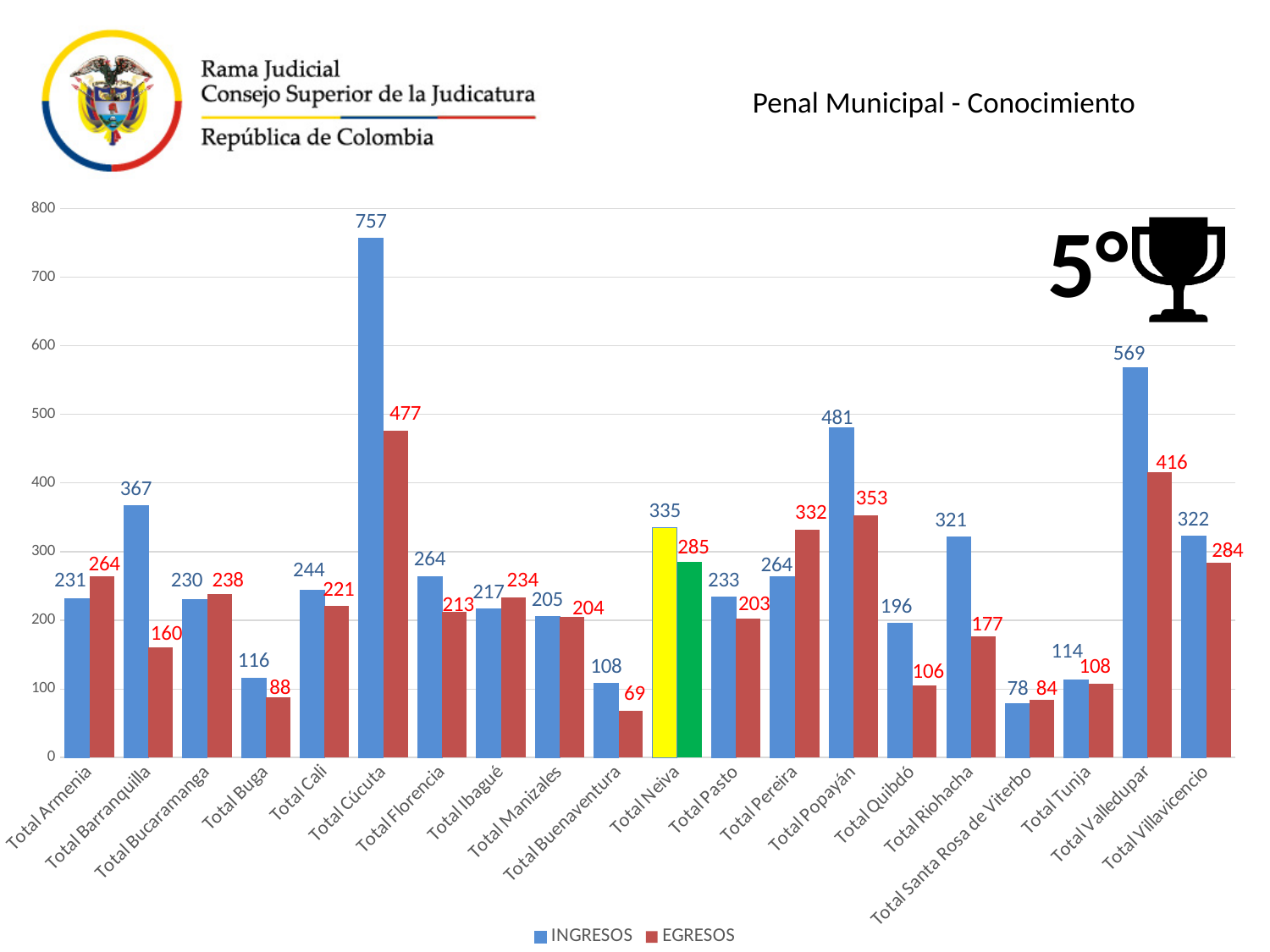
What is the INGRESOS value for Total Santa Rosa de Viterbo? 78 What is the difference between INGRESOS and EGRESOS for Total Valledupar? 153 Which category has the lowest EGRESOS value? Total Buenaventura What is the EGRESOS value for Total Neiva? 285 Which is larger for Total Pereira, INGRESOS or EGRESOS? EGRESOS How many series does the legend list? 2 What kind of chart is shown on the slide? Bar chart What is the title shown above the chart? Penal Municipal - Conocimiento What is the INGRESOS value for Total Cúcuta? 757 Is the INGRESOS value for Total Popayán greater or less than 400? greater How many categories are shown on the x axis? 20 Which category has the highest INGRESOS value? Total Cúcuta